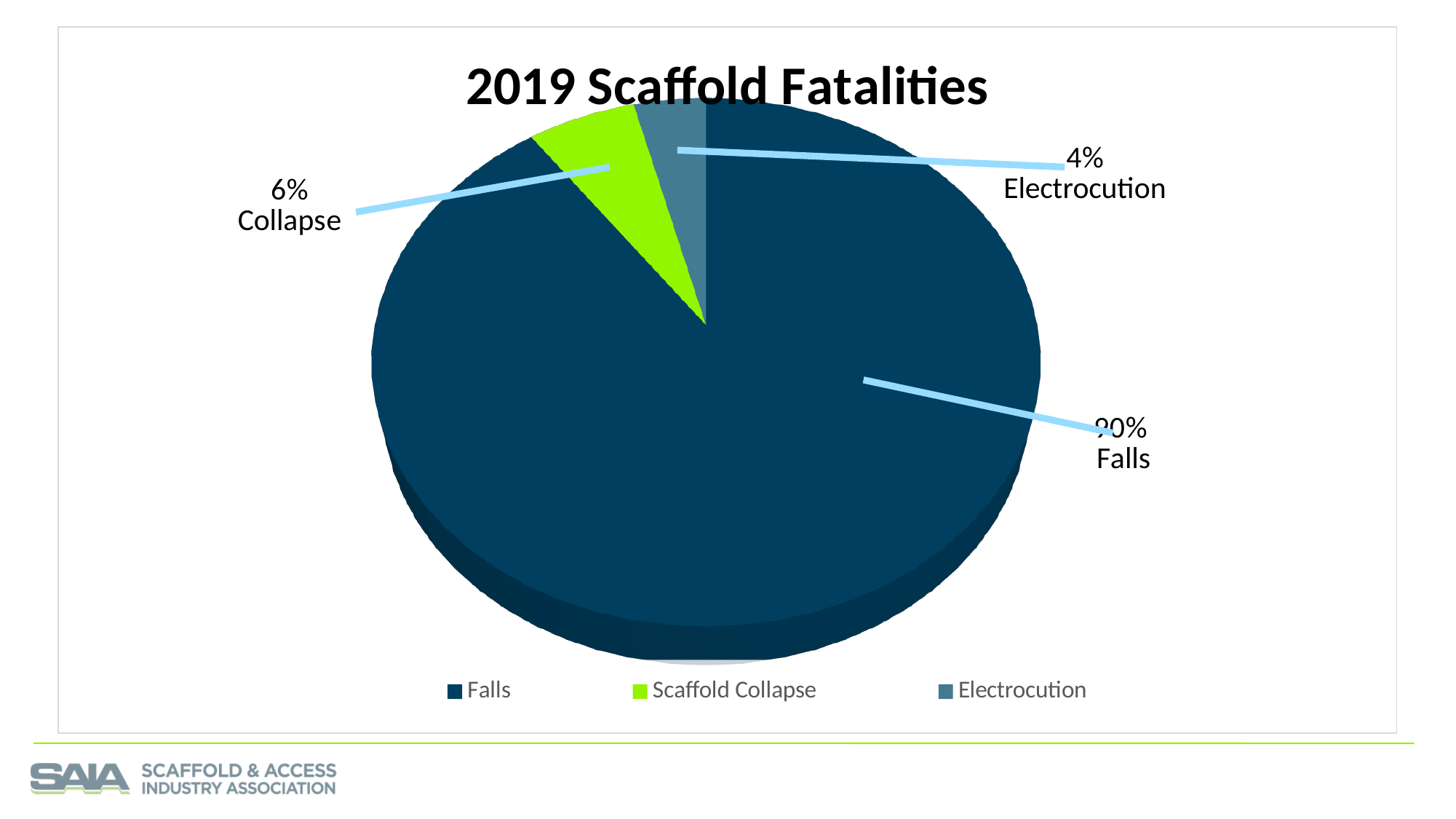
What is the difference in percentage points between the Scaffold Collapse share and the Electrocution share? 2% How many entries does the legend list? 3 Which category accounts for the largest share of 2019 scaffold fatalities? Falls What percentage of 2019 scaffold fatalities were due to Electrocution? 4% What percentage of 2019 scaffold fatalities were due to Scaffold Collapse? 6% What percentage of 2019 scaffold fatalities were due to Falls? 90% How many categories are shown in the pie chart? 3 What type of chart is shown on the slide? pie chart What is the title of the chart? 2019 Scaffold Fatalities Which is larger, the share for Scaffold Collapse or the share for Electrocution? Scaffold Collapse Which category accounts for the smallest share of 2019 scaffold fatalities? Electrocution What colour is the Scaffold Collapse slice in the pie chart? green